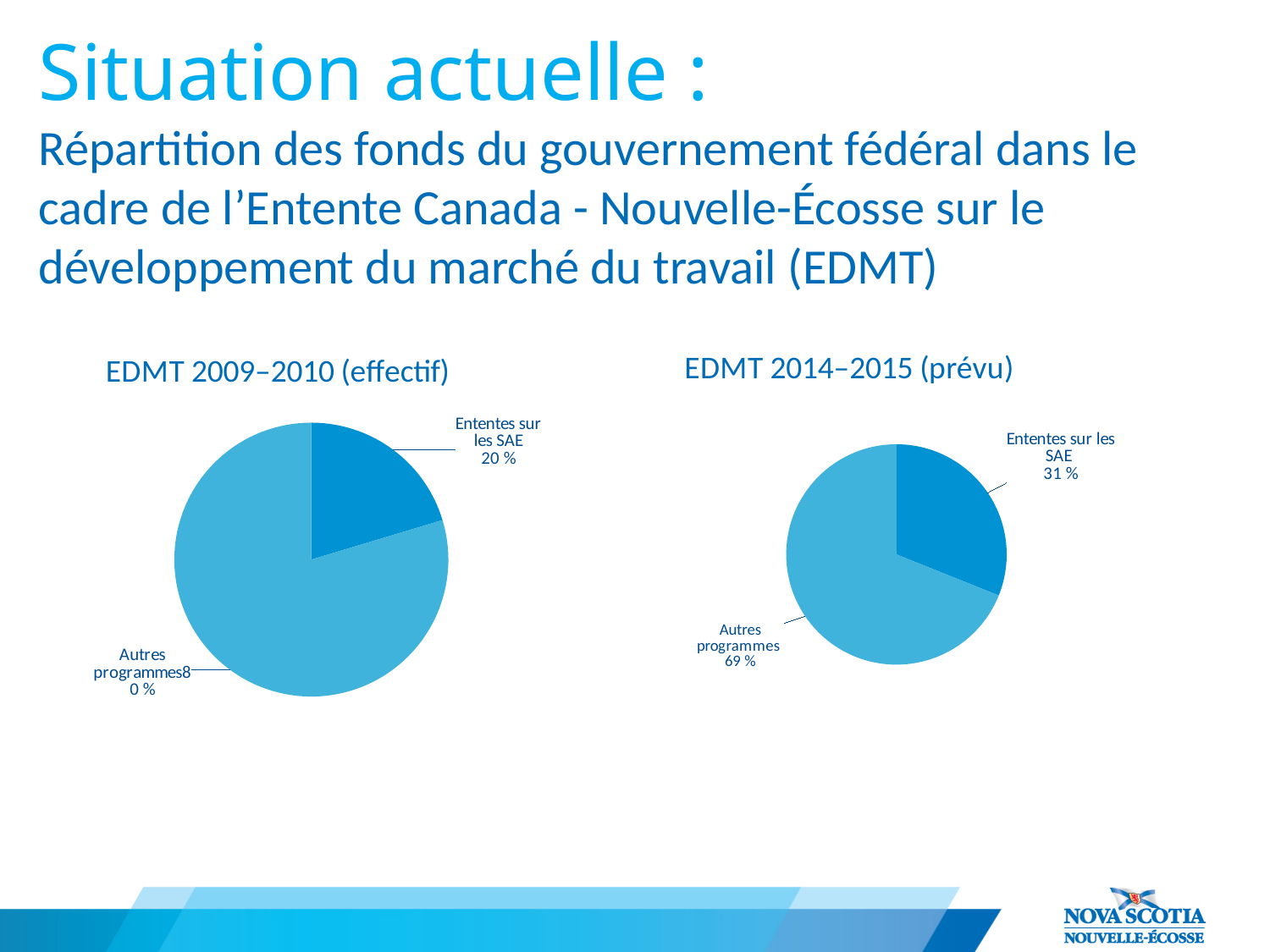
In the EDMT 2014–2015 (prévu) chart, which category has the smallest slice? Ententes sur les SAE What type of chart is used for EDMT 2009–2010 (effectif)? Pie chart In the EDMT 2014–2015 (prévu) chart, what is the difference in percentage points between Autres programmes and Ententes sur les SAE? 38 percentage points In the EDMT 2014–2015 (prévu) chart, what share of funds goes to Autres programmes? 69 % In the EDMT 2009–2010 (effectif) chart, what share of funds goes to Ententes sur les SAE? 20 % How many slices does the EDMT 2014–2015 (prévu) pie chart have? 2 How many pie charts are shown on the slide? 2 In the EDMT 2014–2015 (prévu) chart, which category has the largest slice? Autres programmes By how many percentage points does the Ententes sur les SAE share in EDMT 2014–2015 (prévu) exceed that in EDMT 2009–2010 (effectif)? 11 percentage points Comparing the two charts, is the share for Ententes sur les SAE larger in EDMT 2009–2010 (effectif) or in EDMT 2014–2015 (prévu)? EDMT 2014–2015 (prévu) In the EDMT 2009–2010 (effectif) chart, which category has the smallest slice? Ententes sur les SAE In the EDMT 2014–2015 (prévu) chart, what share of funds goes to Ententes sur les SAE? 31 %